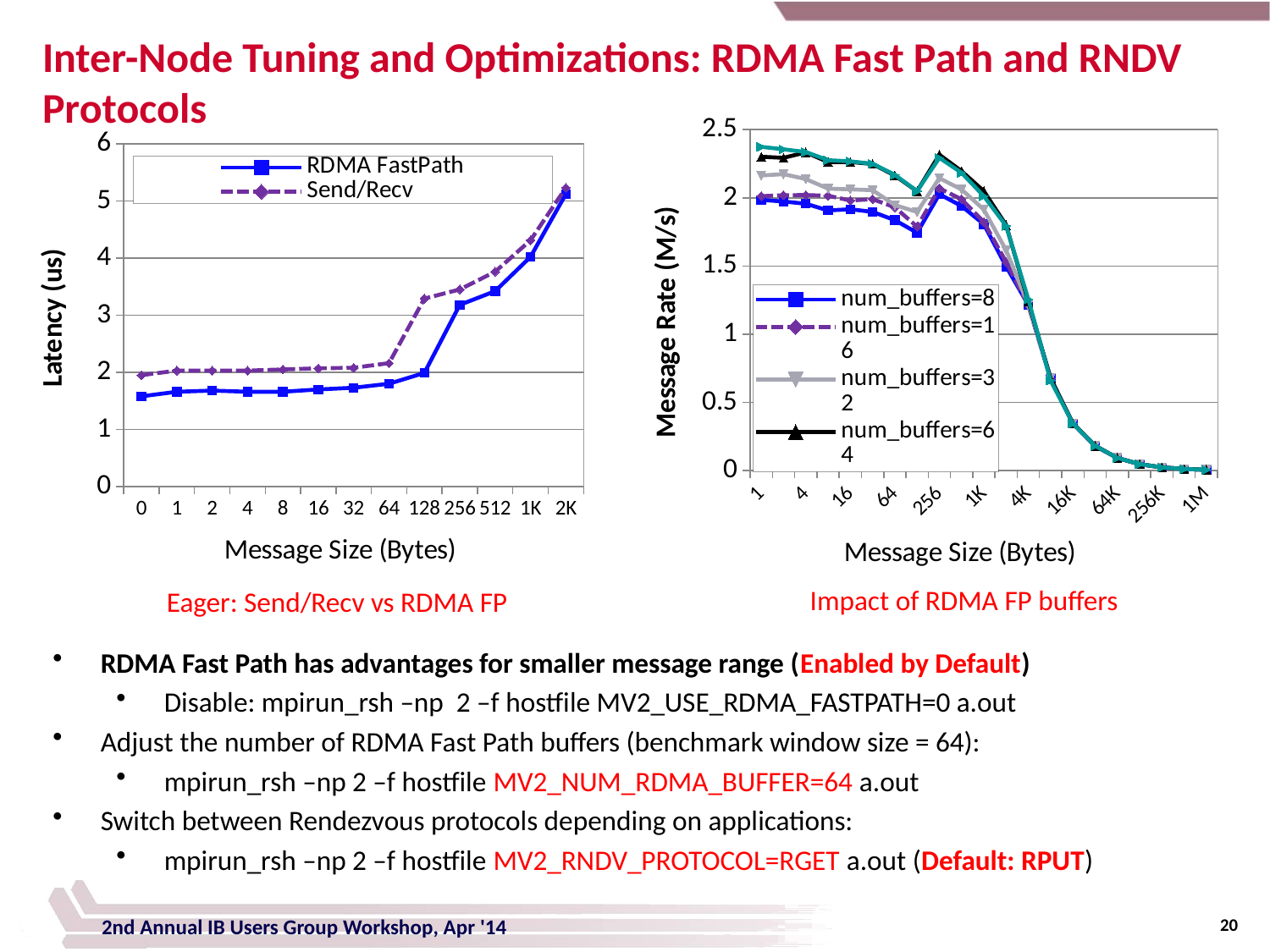
In the right chart (Impact of RDMA FP buffers), which series has the higher message rate at message size 1: num_buffers=8 or num_buffers=64? num_buffers=64 In the left chart (Eager: Send/Recv vs RDMA FP), is the Send/Recv latency at message size 128 greater or less than 3 us? greater In the left chart (Eager: Send/Recv vs RDMA FP), how many message sizes are shown on the x axis? 13 In the left chart (Eager: Send/Recv vs RDMA FP), is the RDMA FastPath latency at message size 64 greater or less than 2 us? less In the left chart (Eager: Send/Recv vs RDMA FP), which series has the higher latency at message size 64? Send/Recv How many series does the legend of the right chart (Impact of RDMA FP buffers) list? 4 In the left chart (Eager: Send/Recv vs RDMA FP), does latency rise or fall as message size increases? Rises What is the y-axis label of the right chart (Impact of RDMA FP buffers)? Message Rate (M/s) How many series does the legend of the left chart (Eager: Send/Recv vs RDMA FP) list? 2 In the right chart (Impact of RDMA FP buffers), is the message rate for num_buffers=64 at message size 1 greater or less than 2 M/s? greater In the right chart (Impact of RDMA FP buffers), does the message rate rise or fall overall as message size increases from 1 to 1M? Falls What type of chart is the left chart titled 'Eager: Send/Recv vs RDMA FP'? Line chart